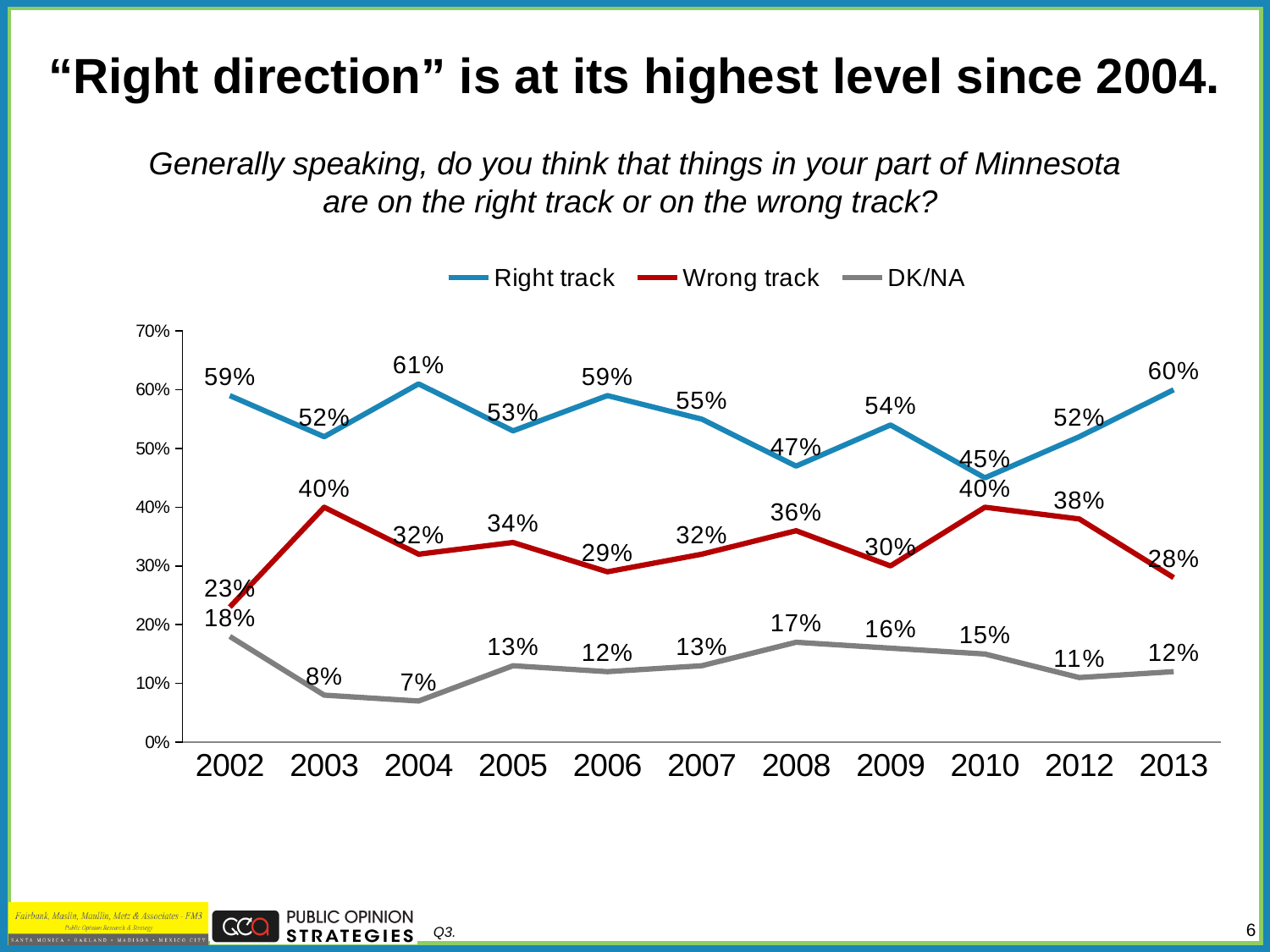
How many series does the legend list? 3 What is the Wrong track value for 2010? 40% What is the difference between the Right track and Wrong track values in 2013? 32 percentage points How many years are plotted along the x axis? 11 Which is larger in 2010: the Right track value or the Wrong track value? Right track What is the DK/NA value for 2004? 7% Does the Wrong track value rise or fall from 2012 to 2013? Fall Which colour is used for the Wrong track line? Red In which year is the Right track value lowest? 2010 What is the Right track value for 2013? 60% What kind of chart is shown on the slide? Line chart In which year is the Right track value highest? 2004